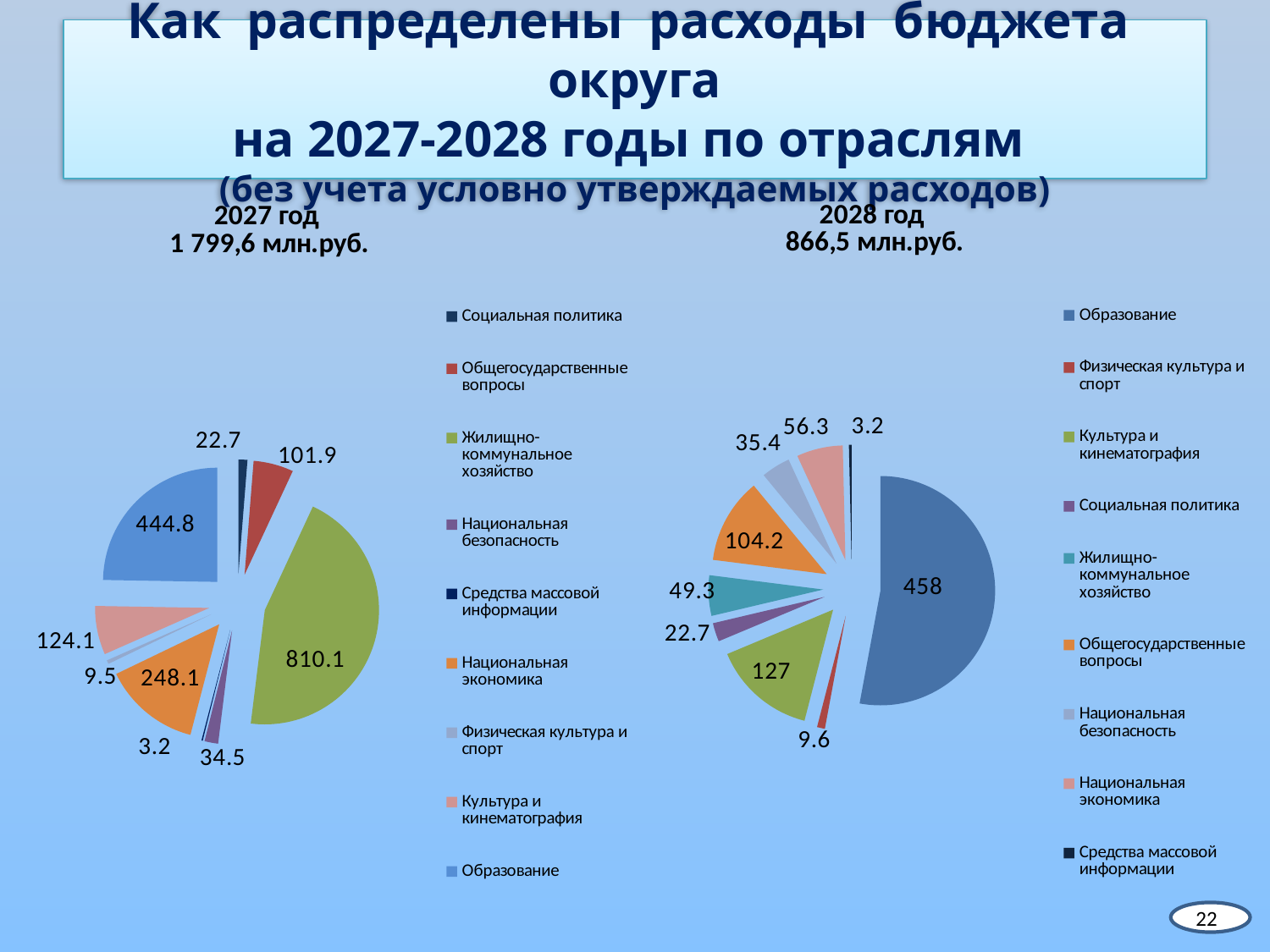
In the 2027 pie chart, which is larger: Национальная экономика or Культура и кинематография? Национальная экономика In the 2027 pie chart, which category has the largest slice? Жилищно-коммунальное хозяйство In the 2028 pie chart, what is the difference between Образование and Культура и кинематография? 331 In the 2027 pie chart, which category has the smallest slice? Средства массовой информации In the 2028 pie chart, what is the value for Культура и кинематография? 127 In the 2027 pie chart, what is the value for Жилищно-коммунальное хозяйство? 810.1 In the 2028 pie chart, which category has the largest slice? Образование In the 2028 pie chart, what is the value for Общегосударственные вопросы? 104.2 What type of chart is used to show the 2027 budget expenditures? Pie chart How many categories does the legend of the 2028 pie chart list? 9 In the 2027 pie chart, what is the value for Образование? 444.8 What total amount is stated for the 2028 budget above the right chart? 866,5 млн.руб.